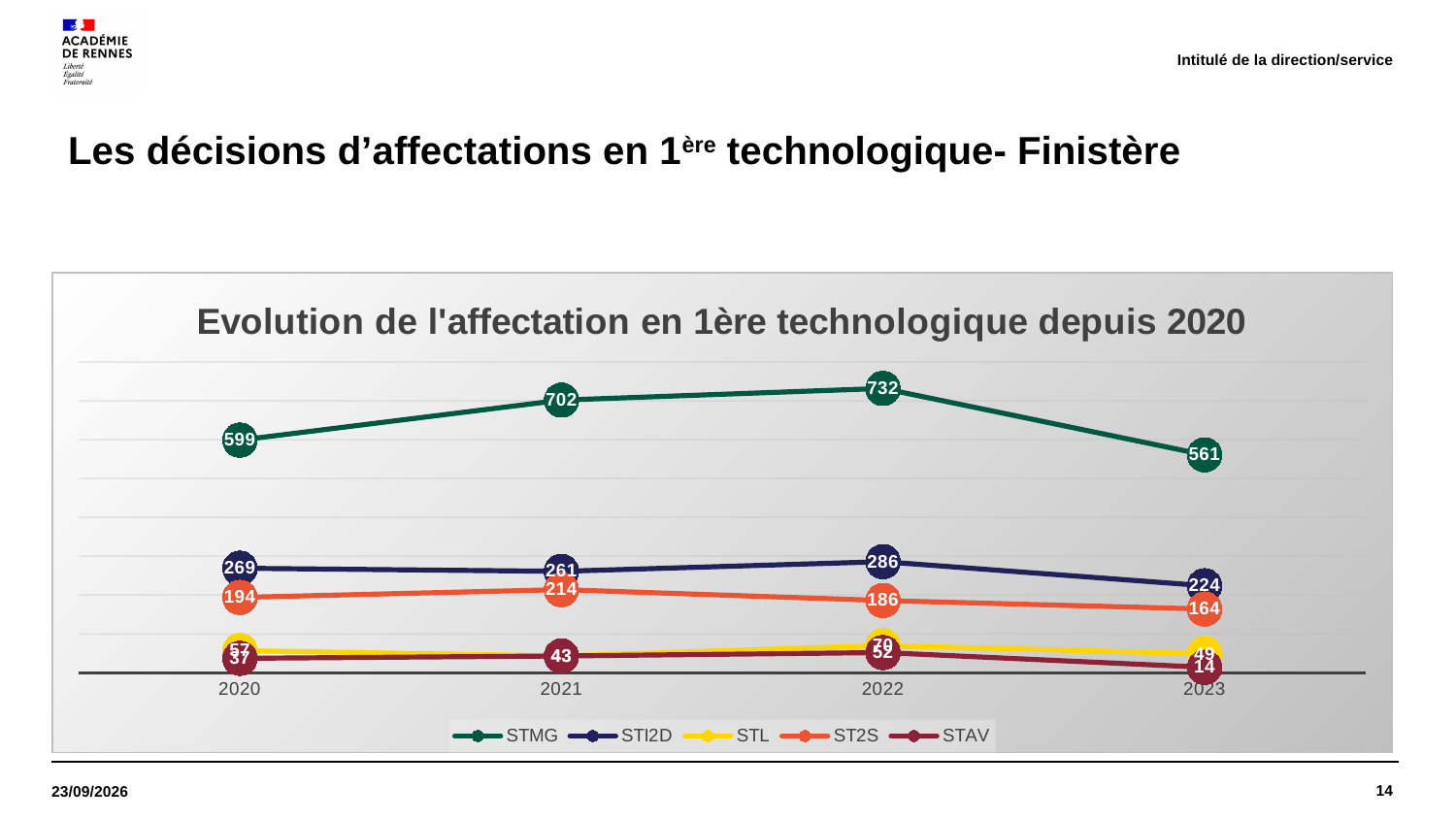
Does the STMG value rise or fall from 2020 to 2022? rise How many years are shown on the x axis? 4 How many series does the legend list? 5 Which is larger in 2020, STI2D or ST2S? STI2D In which year is the STMG value highest? 2022 What is the value for STMG in 2022? 732 What is the value for ST2S in 2021? 214 What is the value for STAV in 2023? 14 What kind of chart is shown? line chart What is the value for STI2D in 2023? 224 What is the difference between the STMG values in 2022 and 2023? 171 In which year is the STMG value lowest? 2023